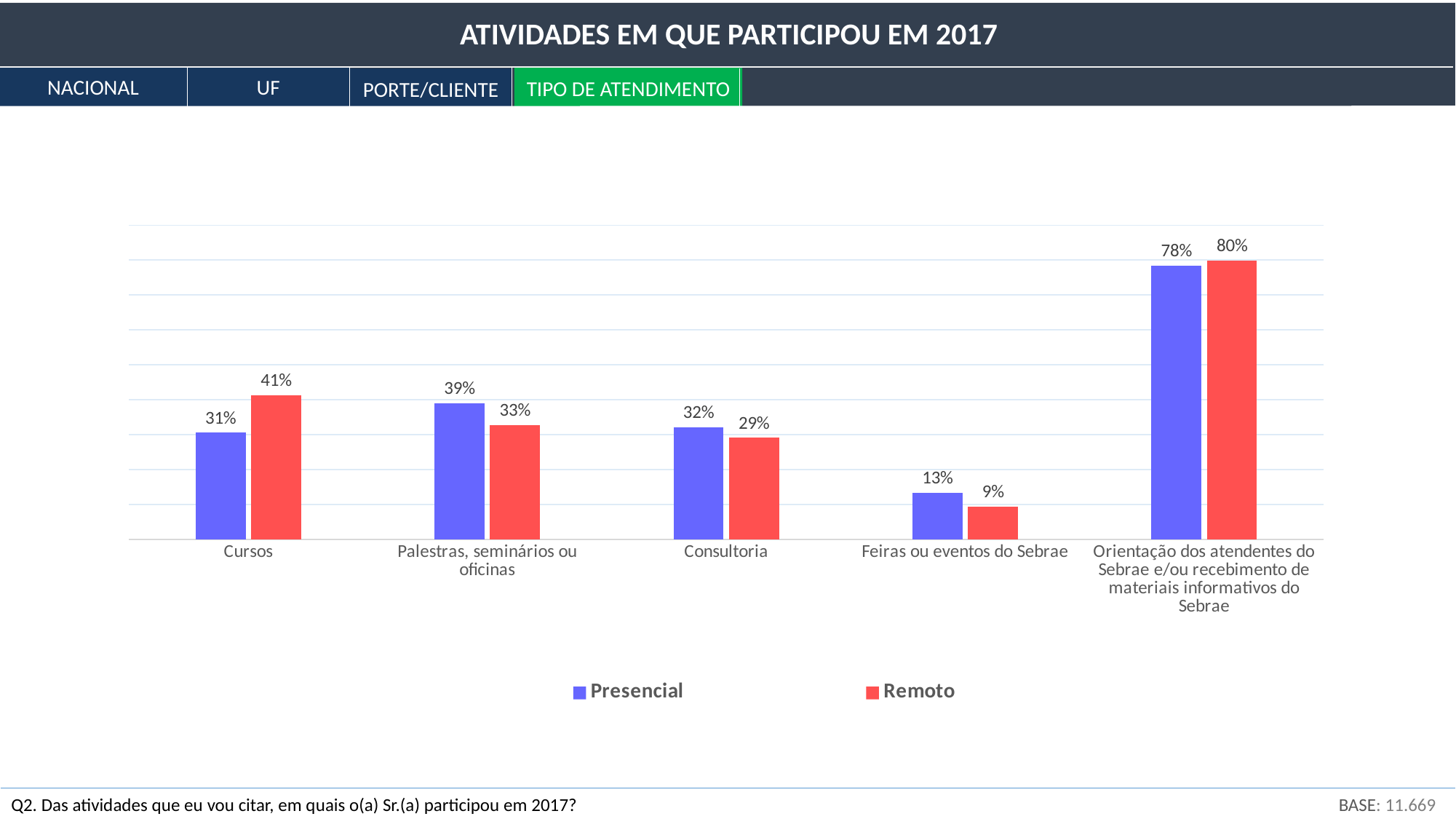
What is the Remoto value for Consultoria? 29% What is the Presencial value for Cursos? 31% What kind of chart is shown on the slide? Bar chart Which category has the lowest Remoto value? Feiras ou eventos do Sebrae What is the difference between the Remoto and Presencial values for Cursos? 10% What is the Remoto value for Feiras ou eventos do Sebrae? 9% Which category has the highest Presencial value? Orientação dos atendentes do Sebrae e/ou recebimento de materiais informativos do Sebrae How many series does the legend list? 2 What is the difference between the Presencial and Remoto values for Palestras, seminários ou oficinas? 6% How many categories are shown on the x axis? 5 What colour represents the Remoto series? Red For Consultoria, which is larger: Presencial or Remoto? Presencial